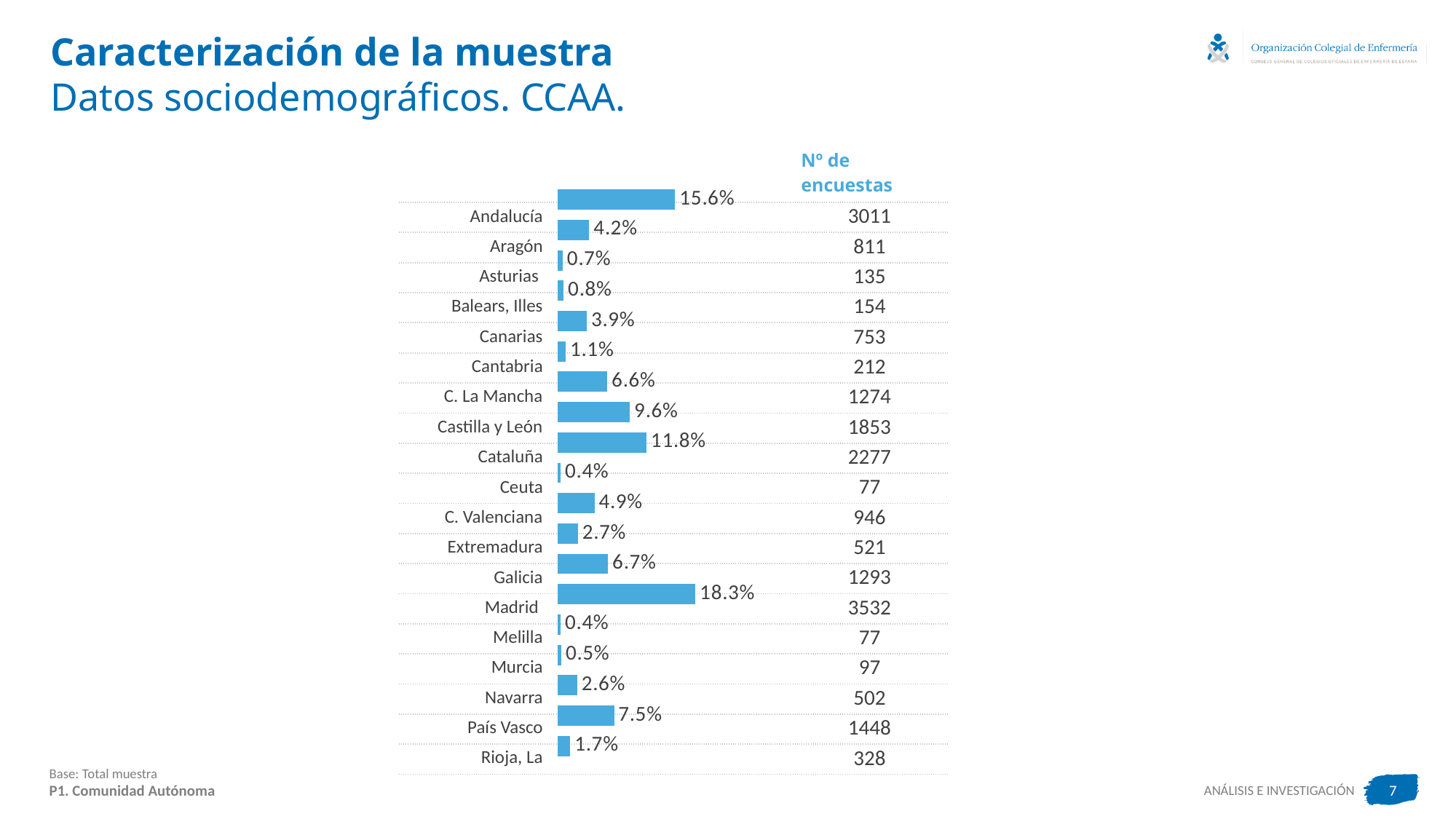
Which autonomous community has the highest share of the sample? Madrid What is the difference in number of surveys between Cataluña and Castilla y León? 424 What is the difference in percentage points between Madrid and Andalucía? 2.7 What percentage of the sample is from Cataluña? 11.8% How many surveys (Nº de encuestas) were collected in Andalucía? 3011 What type of chart is used on this slide? Bar chart Which has a larger share of the sample, Galicia or C. La Mancha? Galicia How many surveys (Nº de encuestas) were collected in País Vasco? 1448 What is the heading of the numeric column to the right of the bars? Nº de encuestas Which has more surveys, Aragón or Canarias? Aragón What percentage of the sample is from Madrid? 18.3% How many autonomous communities are shown in the chart? 19